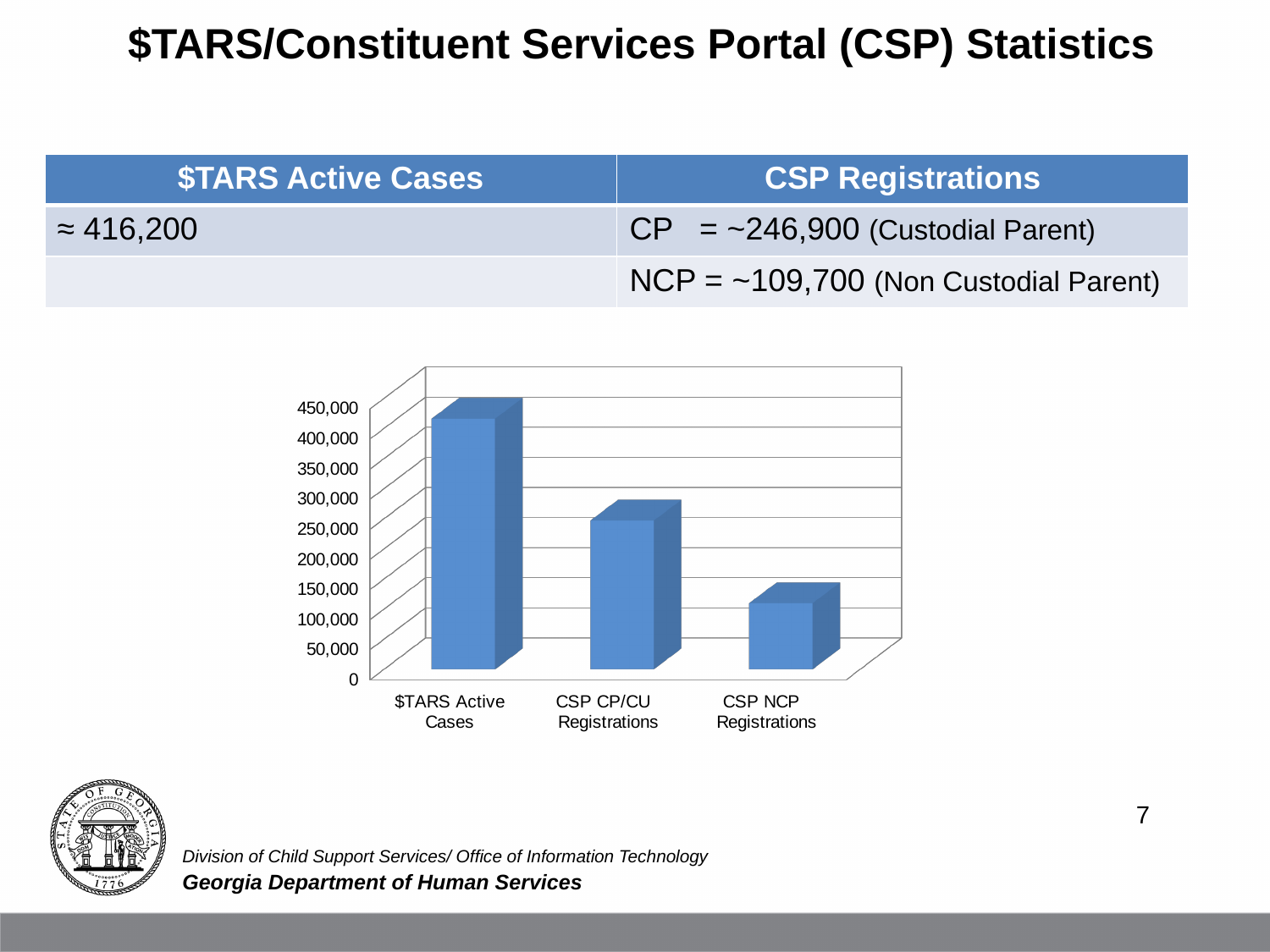
Which is larger in the chart, CSP CP/CU Registrations or CSP NCP Registrations? CSP CP/CU Registrations Is the value for CSP CP/CU Registrations greater or less than 200,000? greater What is the highest value shown on the chart's vertical axis? 450,000 What kind of chart is shown on the slide? bar chart Do the bar values rise or fall from left to right across the chart? fall Which category has the lowest bar in the chart? CSP NCP Registrations How many categories are plotted in the bar chart? 3 Is the value for CSP CP/CU Registrations greater or less than 300,000? less Is the value for $TARS Active Cases greater or less than 350,000? greater Which category has the highest bar in the chart? $TARS Active Cases